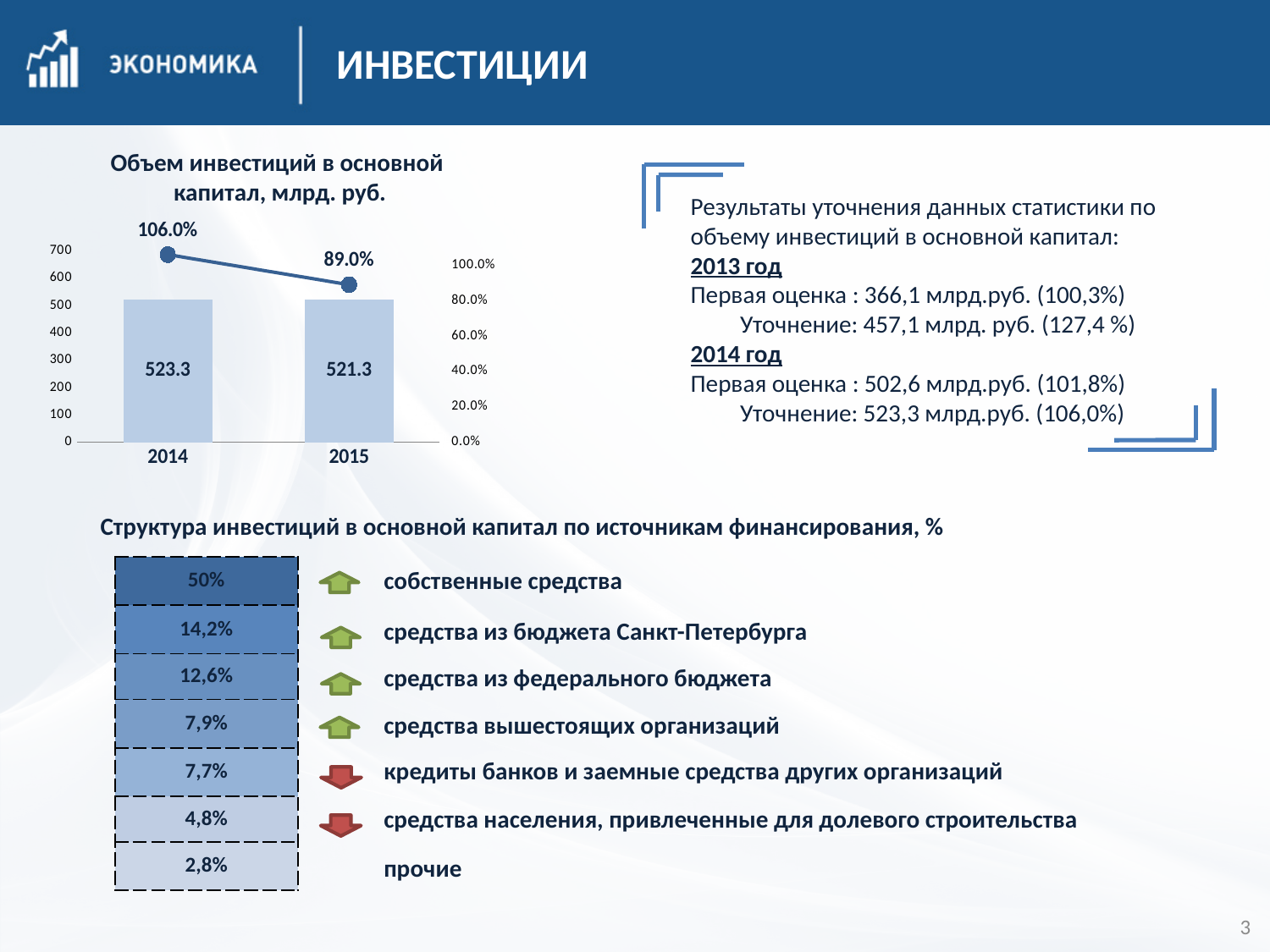
In the chart 'Объем инвестиций в основной капитал, млрд. руб.', what is the value of the bar for 2015? 521.3 In the chart 'Объем инвестиций в основной капитал, млрд. руб.', is the bar value for 2015 greater or less than 500? greater In the chart 'Объем инвестиций в основной капитал, млрд. руб.', what is the difference between the bar values for 2014 and 2015? 2.0 In the diagram 'Структура инвестиций в основной капитал по источникам финансирования, %', what share is shown for 'собственные средства'? 50% In the diagram 'Структура инвестиций в основной капитал по источникам финансирования, %', which source has the smallest share? прочие In the chart 'Объем инвестиций в основной капитал, млрд. руб.', what is the value of the bar for 2014? 523.3 In the chart 'Объем инвестиций в основной капитал, млрд. руб.', does the percentage line rise or fall from 2014 to 2015? fall In the chart 'Объем инвестиций в основной капитал, млрд. руб.', what is the highest value on the left vertical axis? 700 In the chart 'Объем инвестиций в основной капитал, млрд. руб.', how many years are shown on the x axis? 2 In the chart 'Объем инвестиций в основной капитал, млрд. руб.', what percentage is shown by the line marker for 2014? 106.0% In the chart 'Объем инвестиций в основной капитал, млрд. руб.', what percentage is shown by the line marker for 2015? 89.0% In the chart 'Объем инвестиций в основной капитал, млрд. руб.', what is the difference between the percentage values for 2014 and 2015? 17.0%